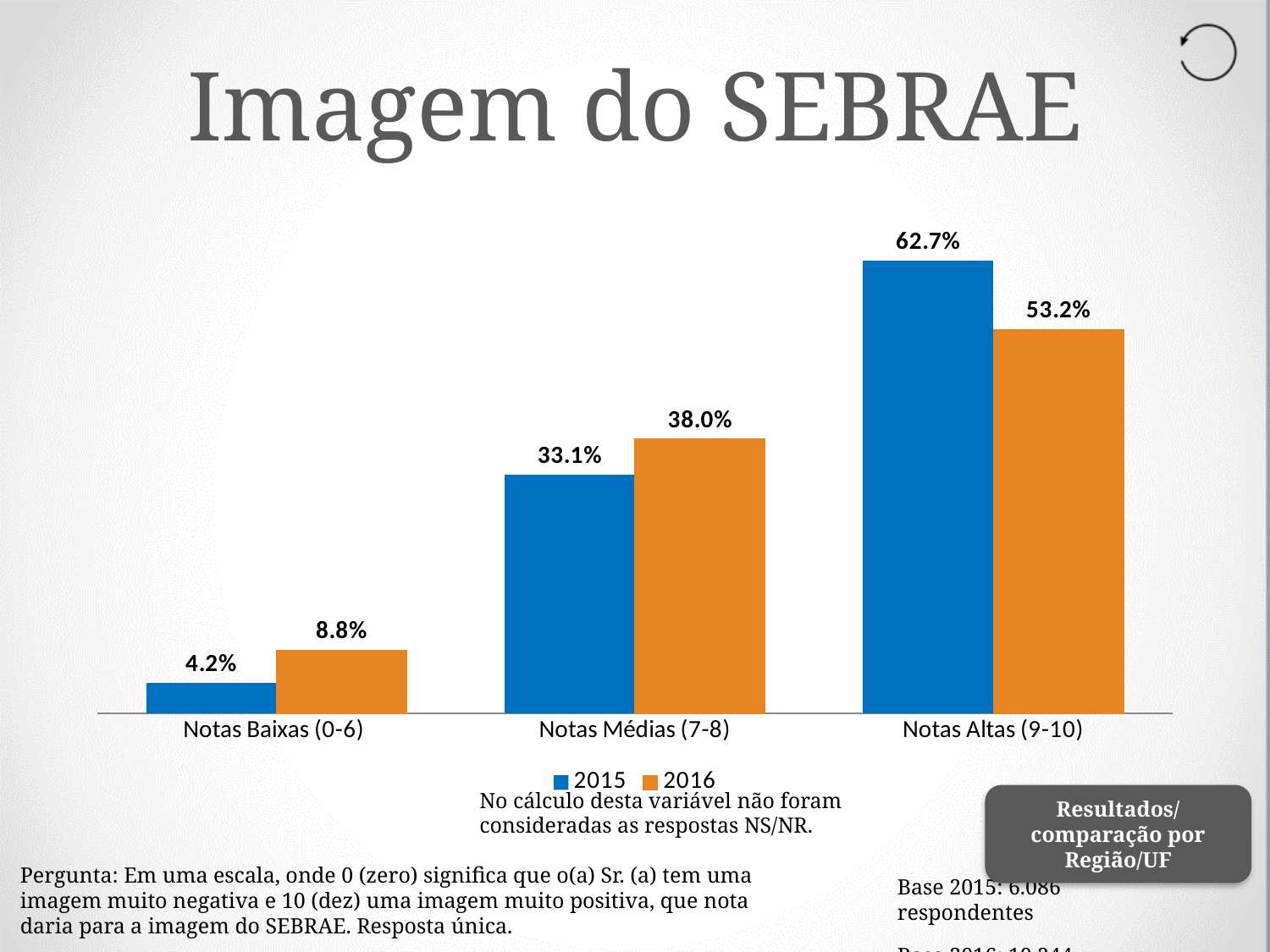
Which colour represents the 2016 series? Orange What is the difference between the 2015 and 2016 values for Notas Altas (9-10)? 9.5% How many series does the legend list? 2 What is the value for Notas Baixas (0-6) in 2016? 8.8% Which category has the lowest value for 2015? Notas Baixas (0-6) How many categories are shown on the x axis? 3 What is the difference between the 2016 and 2015 values for Notas Médias (7-8)? 4.9% What is the value for Notas Médias (7-8) in 2015? 33.1% What kind of chart is shown on the slide? Bar chart What is the value for Notas Altas (9-10) in 2015? 62.7% Which category has the highest value for 2016? Notas Altas (9-10) Which is larger for Notas Médias (7-8): the 2015 value or the 2016 value? 2016